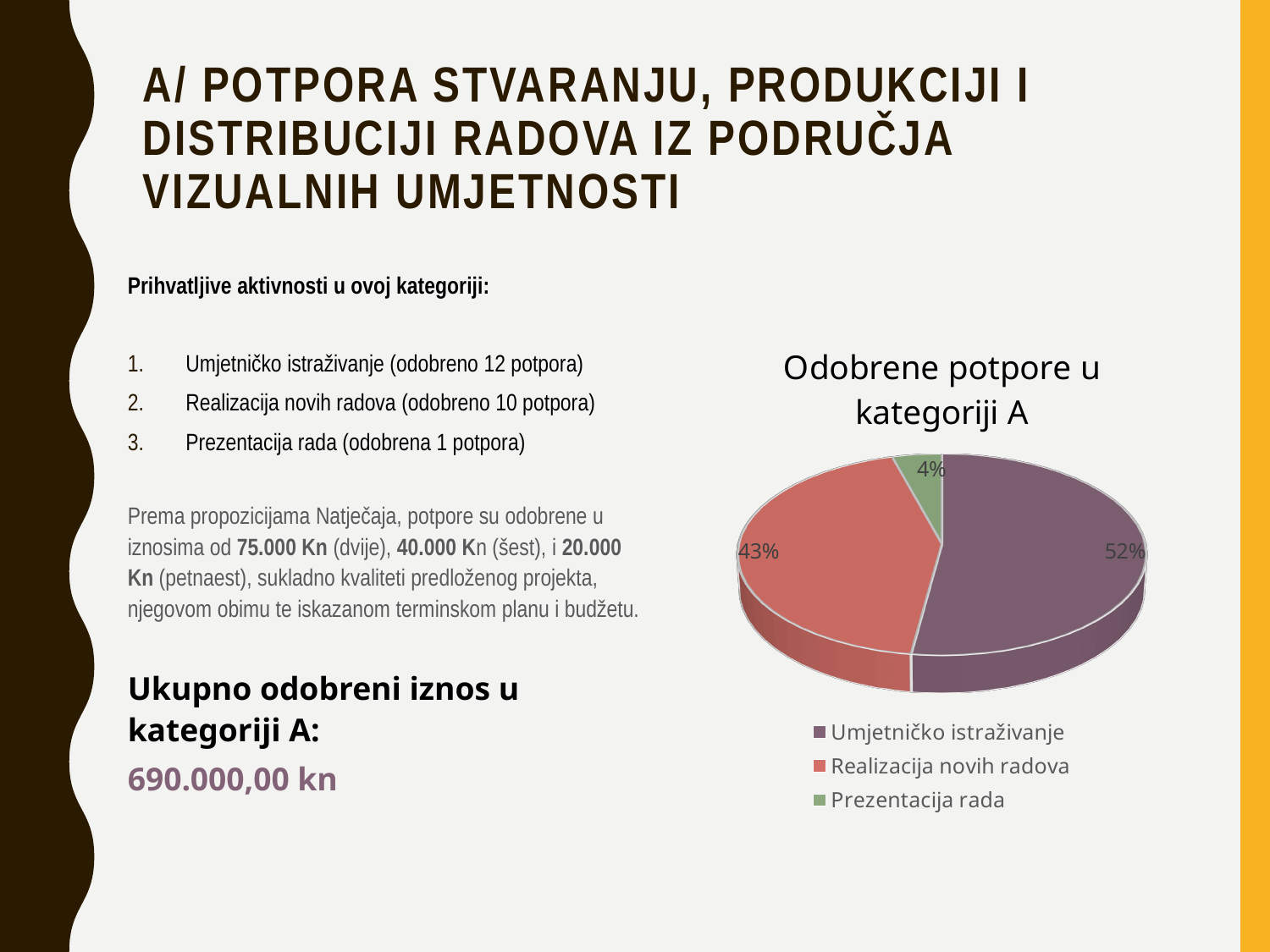
How many entries does the legend list? 3 What kind of chart is shown on the slide? pie chart Which colour represents Realizacija novih radova in the pie chart? red Which category has the largest slice of the pie? Umjetničko istraživanje What share of the pie does Realizacija novih radova have? 43% What is the title of the chart? Odobrene potpore u kategoriji A What is the difference in percentage points between Umjetničko istraživanje and Realizacija novih radova? 9 What share of the pie does Prezentacija rada have? 4% How many slices does the pie chart have? 3 Which is larger, the slice for Realizacija novih radova or the slice for Prezentacija rada? Realizacija novih radova What share of the pie does Umjetničko istraživanje have? 52% Which category has the smallest slice of the pie? Prezentacija rada